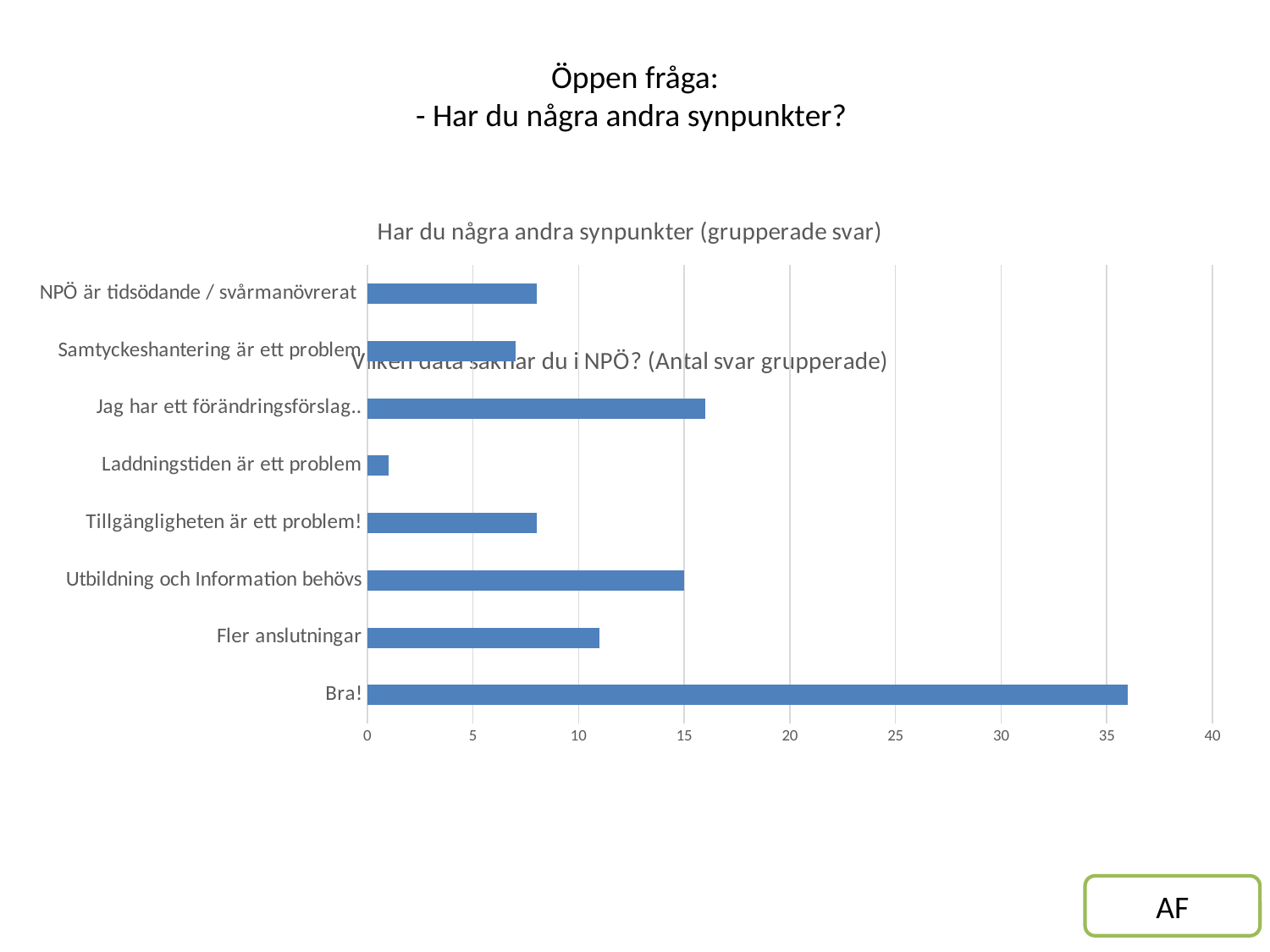
Is the value for Utbildning och Information behövs greater or less than 20? less Which category has the highest value in the chart? Bra! What is the title of the chart? Har du några andra synpunkter (grupperade svar) How many categories are plotted in the chart? 8 Is the value for Jag har ett förändringsförslag.. greater or less than 10? greater What kind of chart is shown on the slide? bar chart Is the value for Fler anslutningar greater or less than 10? greater Which is larger, the value for Bra! or the value for Fler anslutningar? Bra! Which category has the lowest value in the chart? Laddningstiden är ett problem Which is larger, the value for Jag har ett förändringsförslag.. or the value for Samtyckeshantering är ett problem? Jag har ett förändringsförslag..